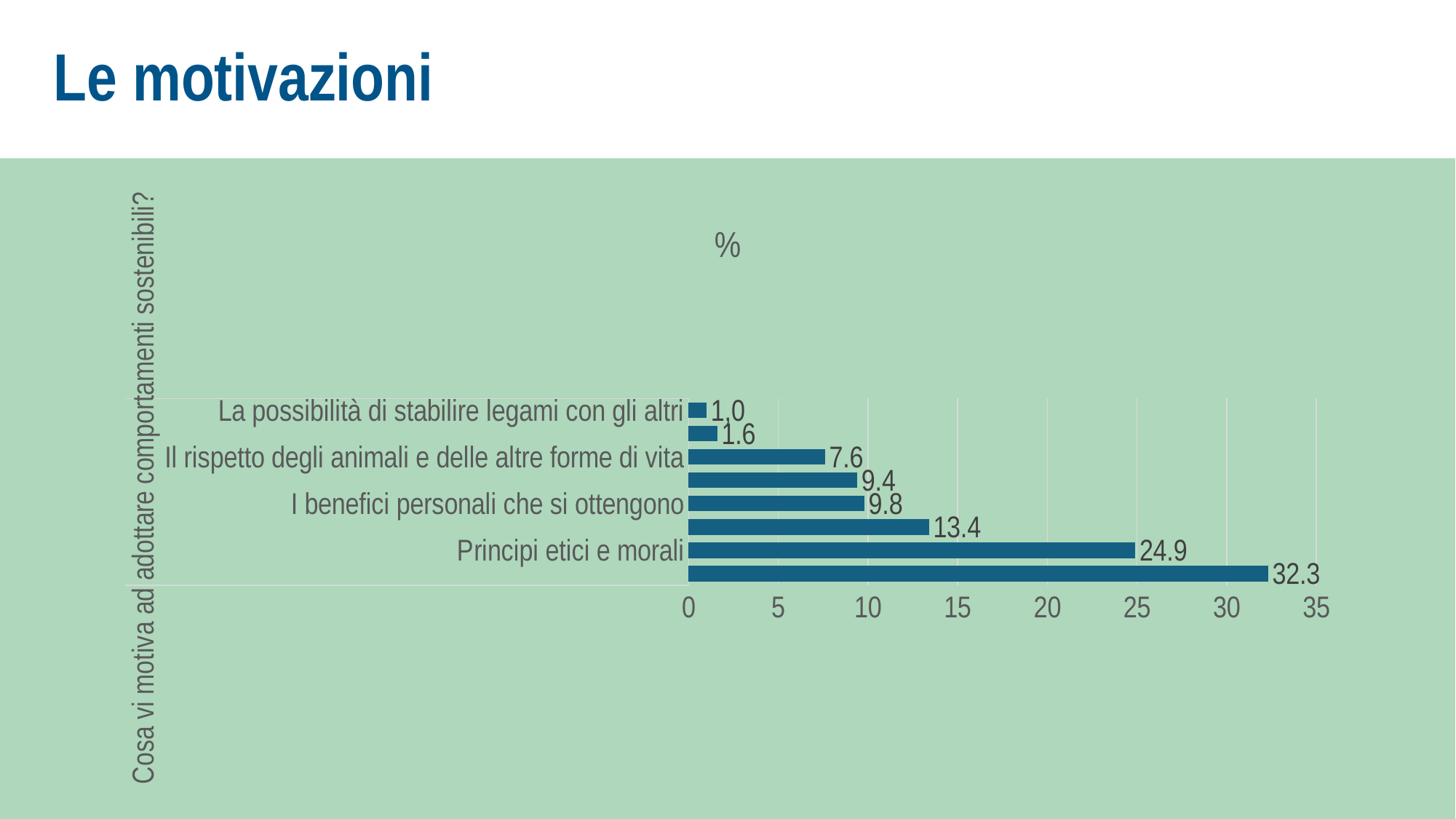
Which labelled category has the lowest value? La possibilità di stabilire legami con gli altri What is the value for 'Principi etici e morali'? 24.9 Is the value for 'Principi etici e morali' greater or less than 20? greater What is the difference between the values for 'Principi etici e morali' and 'I benefici personali che si ottengono'? 15.1 What kind of chart is shown on the slide? bar chart What is the largest value printed on the chart? 32.3 What is the value for 'Il rispetto degli animali e delle altre forme di vita'? 7.6 Which is larger: 'Principi etici e morali' or 'Il rispetto degli animali e delle altre forme di vita'? Principi etici e morali What is the difference between the values for 'I benefici personali che si ottengono' and 'Il rispetto degli animali e delle altre forme di vita'? 2.2 How many bars are plotted in the chart? 8 What is the value for 'La possibilità di stabilire legami con gli altri'? 1.0 What is the value for 'I benefici personali che si ottengono'? 9.8